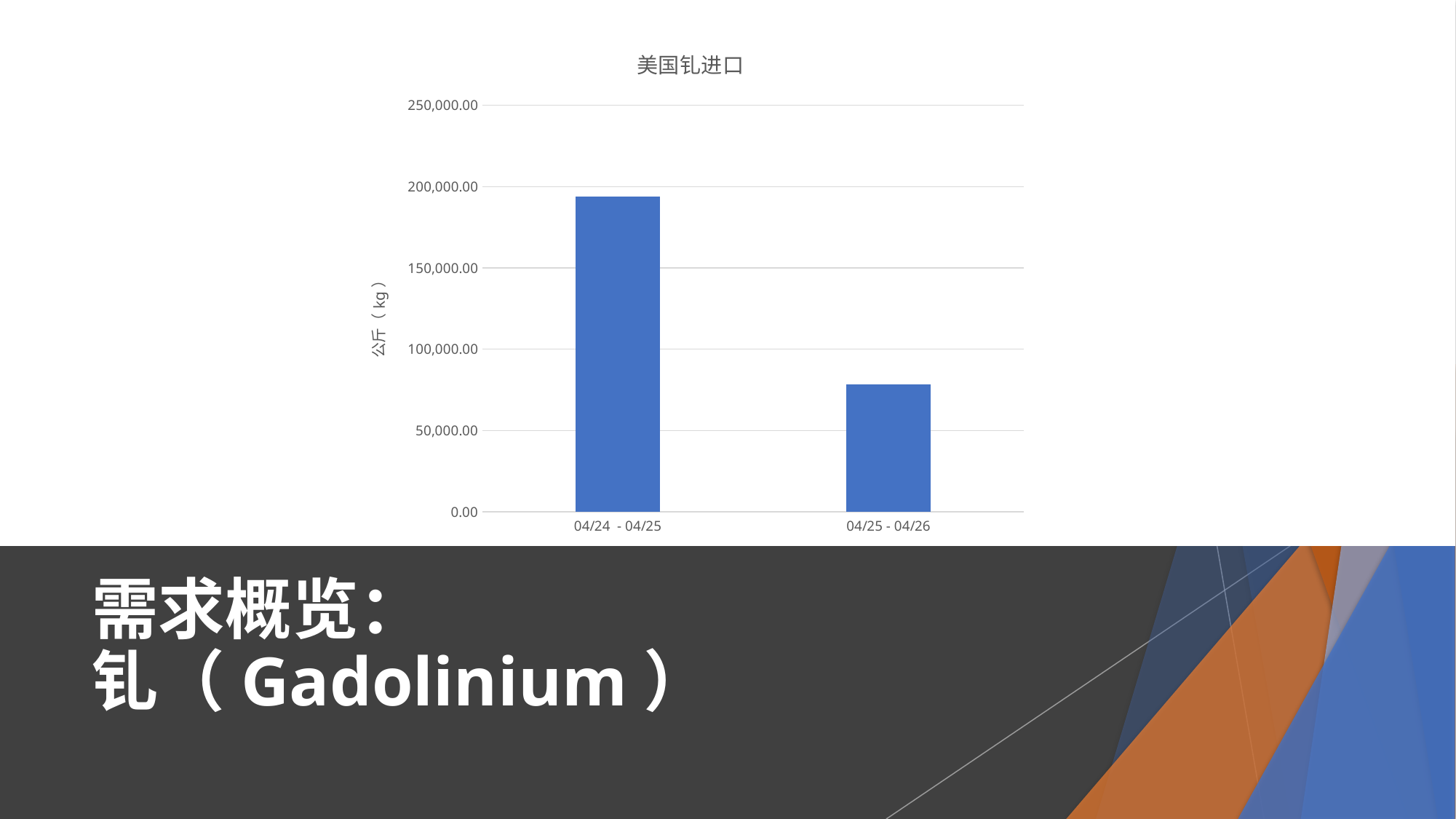
Is the value for 04/24 - 04/25 greater or less than 200,000.00? less Is the value for 04/25 - 04/26 greater or less than 50,000.00? greater What is the label on the y axis? 公斤（kg） Do the values rise or fall from 04/24 - 04/25 to 04/25 - 04/26? fall What kind of chart is shown on the slide? bar chart How many categories are plotted on the x axis? 2 Is the value for 04/25 - 04/26 greater or less than 100,000.00? less What is the title of the chart? 美国钆进口 Which category has the highest value? 04/24 - 04/25 Which is larger, the value for 04/24 - 04/25 or the value for 04/25 - 04/26? 04/24 - 04/25 Which category has the lowest value? 04/25 - 04/26